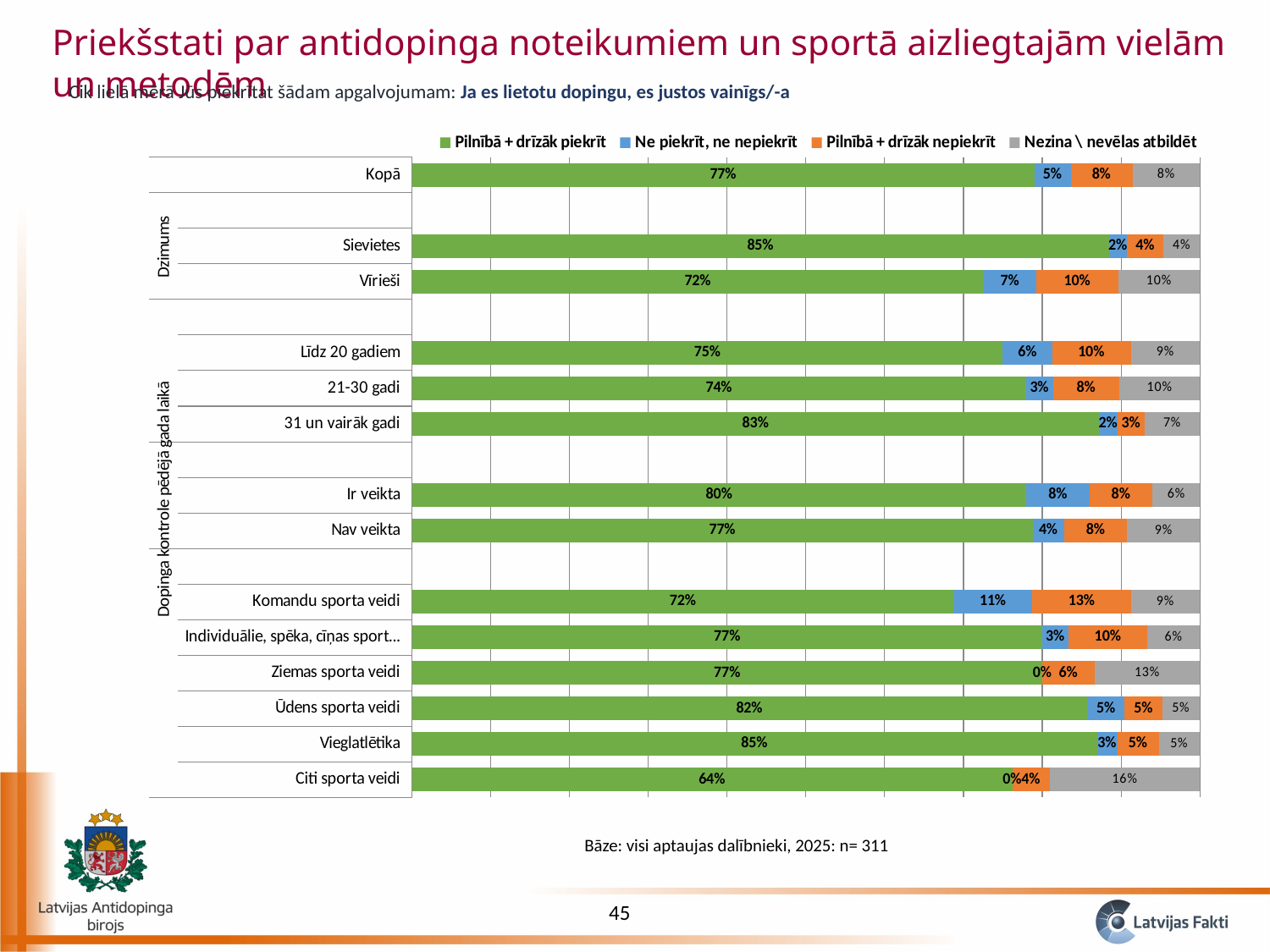
What is the 'Ne piekrīt, ne nepiekrīt' value for Vīrieši? 7% How many series does the legend list? 4 What is the difference in the 'Pilnībā + drīzāk piekrīt' value between Sievietes and Vīrieši? 13 percentage points Which category has the highest 'Nezina \ nevēlas atbildēt' value? Citi sporta veidi Which category has the lowest 'Pilnībā + drīzāk piekrīt' value? Citi sporta veidi Which has a larger 'Pilnībā + drīzāk piekrīt' value, Ir veikta or Nav veikta? Ir veikta How many categories are plotted in the chart? 14 What is the 'Pilnībā + drīzāk nepiekrīt' value for Komandu sporta veidi? 13% What kind of chart is shown on the slide? Stacked bar chart Which category has the highest 'Ne piekrīt, ne nepiekrīt' value? Komandu sporta veidi What percentage of Kopā respondents fall in the 'Pilnībā + drīzāk piekrīt' series? 77% What is the 'Nezina \ nevēlas atbildēt' value for Citi sporta veidi? 16%